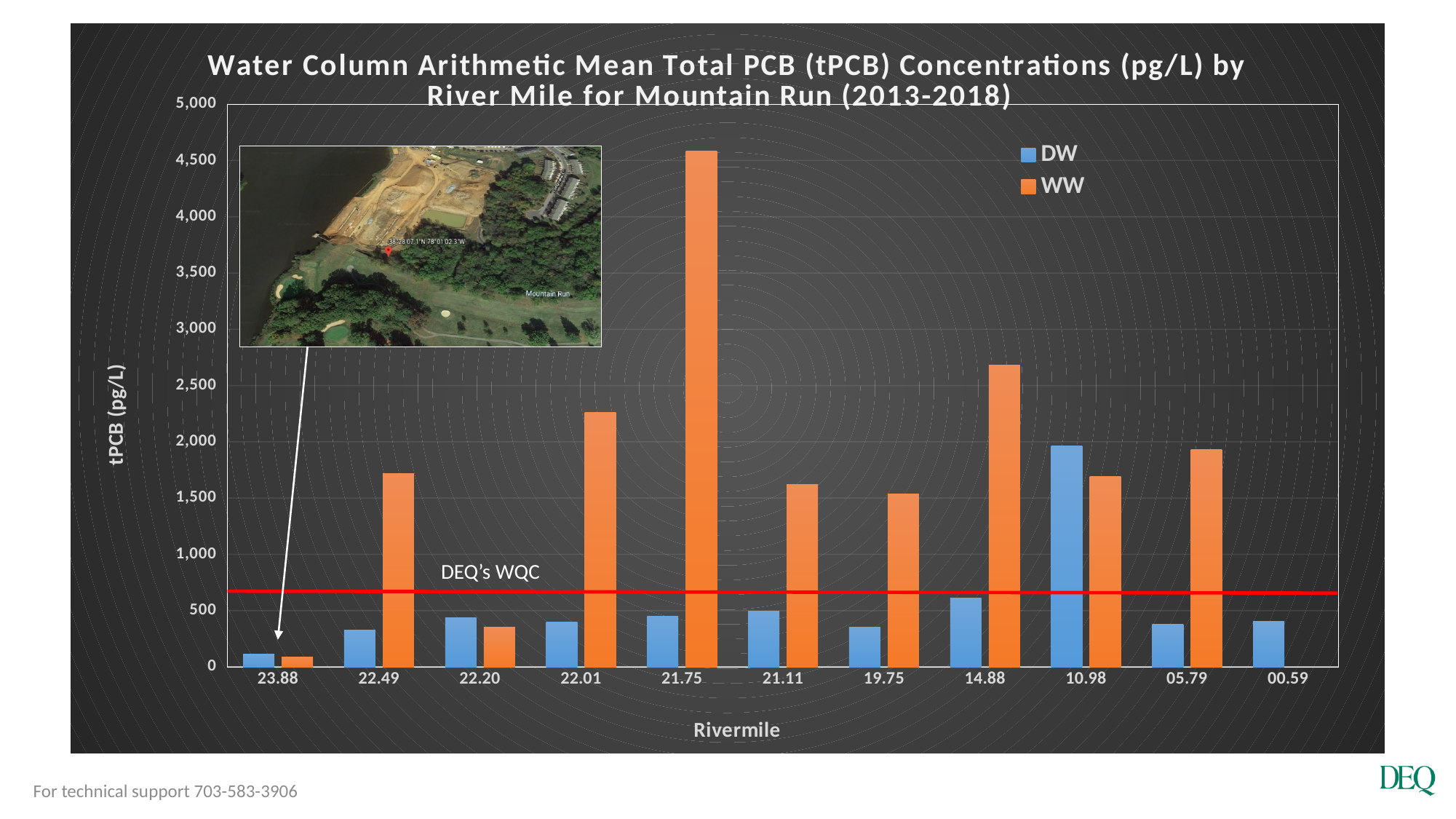
Is the DW value at river mile 22.49 greater or less than 500? less At river mile 10.98, which series has the larger value, DW or WW? DW Is the WW value at river mile 14.88 greater or less than 2,500? greater What does the red horizontal line on the chart represent? DEQ's WQC Which river mile has the highest WW value? 21.75 At river mile 22.49, which series has the larger value, DW or WW? WW Is the WW value at river mile 21.75 greater or less than 4,000? greater How many river mile categories are shown on the x axis? 11 Which river mile has the lowest WW value? 23.88 How many series does the legend list? 2 What kind of chart is shown on the slide? bar chart Which river mile has the highest DW value? 10.98